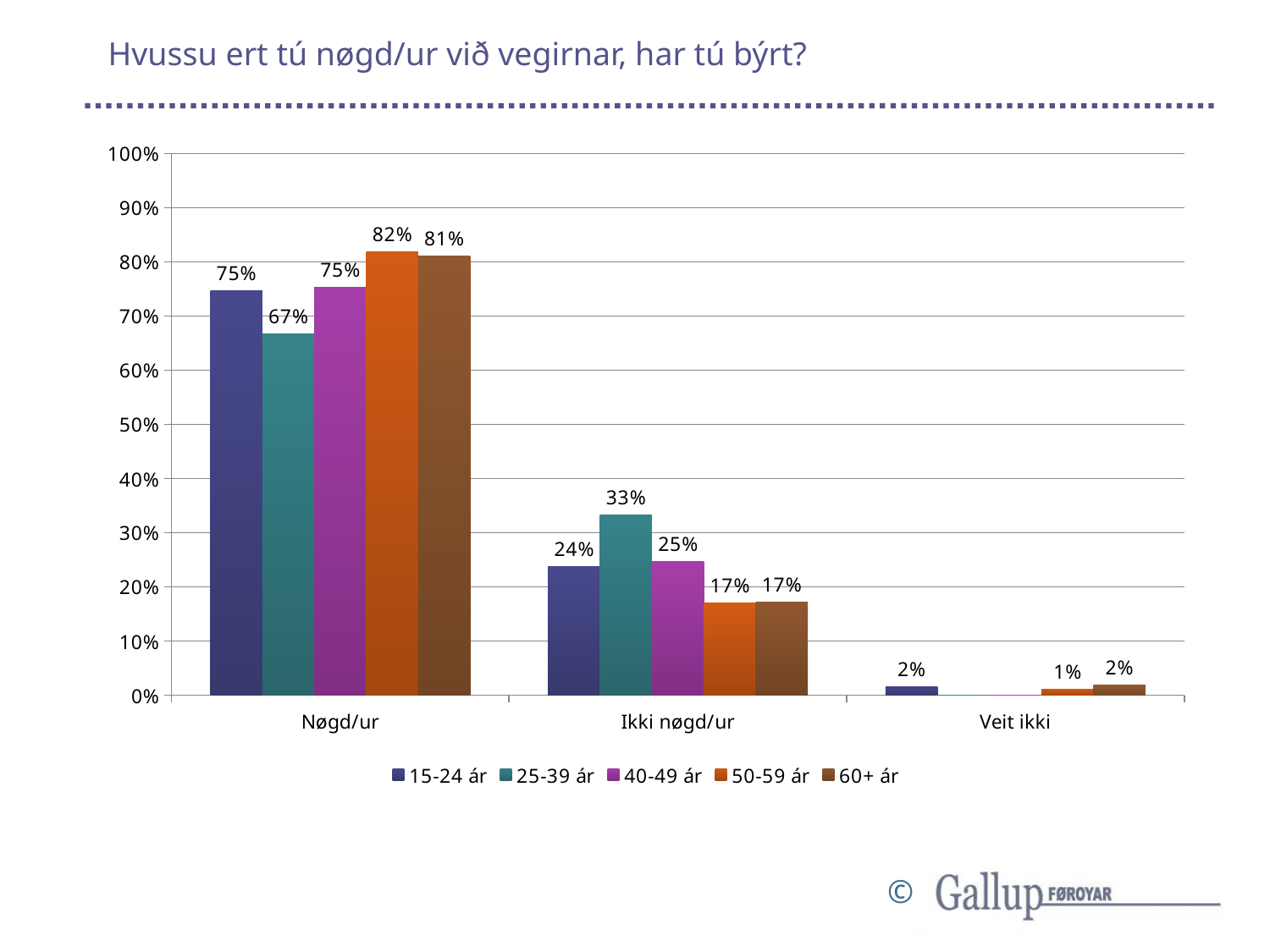
What is the value for 60+ ár in the Veit ikki category? 2% What kind of chart is shown on the slide? bar chart Is the value for 25-39 ár in the Nøgd/ur category greater or less than 70%? less How many categories are shown on the x axis? 3 What is the title of the chart? Hvussu ert tú nøgd/ur við vegirnar, har tú býrt? What is the difference between the 25-39 ár and 50-59 ár values in the Ikki nøgd/ur category? 16% Which age group has the highest value in the Nøgd/ur category? 50-59 ár What is the value for 50-59 ár in the Nøgd/ur category? 82% In the Ikki nøgd/ur category, which is larger: the value for 15-24 ár or the value for 40-49 ár? 40-49 ár Which age group has the lowest value in the Nøgd/ur category? 25-39 ár How many series does the legend list? 5 What is the value for 25-39 ár in the Ikki nøgd/ur category? 33%